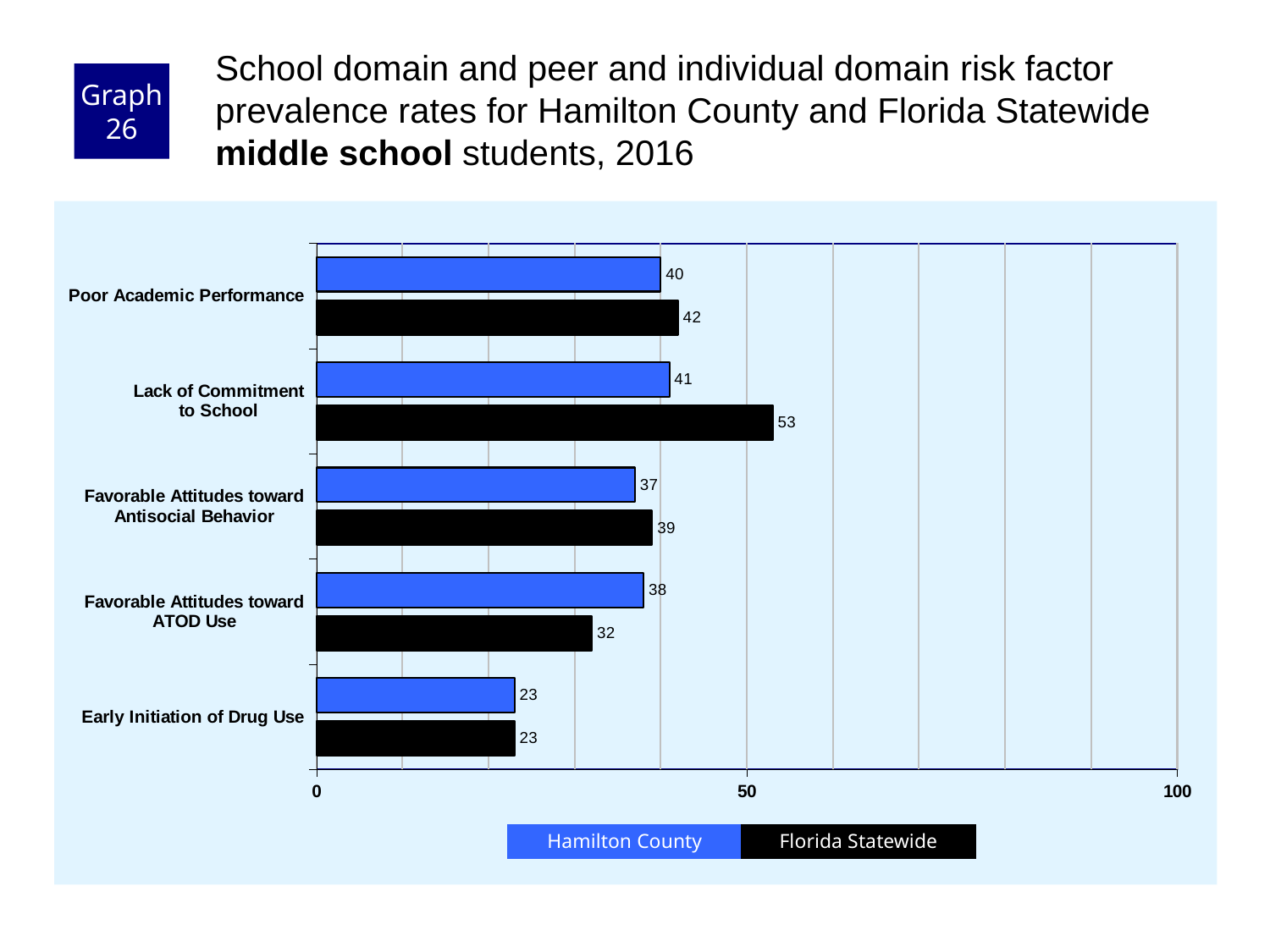
Which risk factor has the highest Florida Statewide value? Lack of Commitment to School What is the Hamilton County value for Favorable Attitudes toward ATOD Use? 38 How many series does the legend list? 2 For Favorable Attitudes toward ATOD Use, which is larger: Hamilton County or Florida Statewide? Hamilton County What is the difference between the Florida Statewide and Hamilton County values for Lack of Commitment to School? 12 Which risk factor has the lowest Hamilton County value? Early Initiation of Drug Use Which colour represents Florida Statewide in the chart? black What is the Hamilton County value for Poor Academic Performance? 40 What is the Florida Statewide value for Lack of Commitment to School? 53 What kind of chart is shown on the slide? bar chart Is the Florida Statewide value for Lack of Commitment to School greater or less than 50? greater How many risk factor categories are shown on the chart? 5